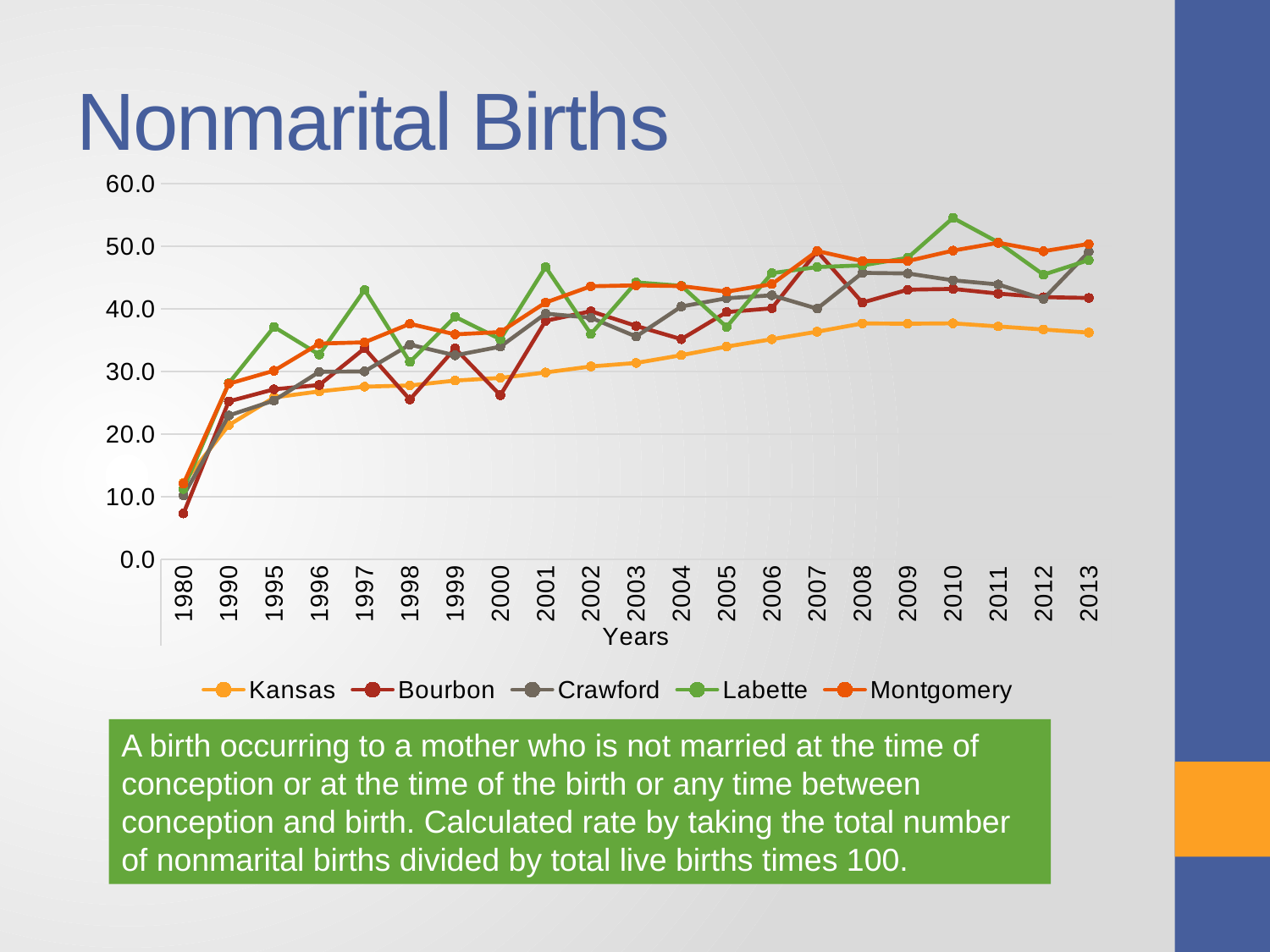
Is the value for Labette in 2010 greater or less than 50? greater How many years are plotted along the x axis? 21 Is the value for Bourbon in 2000 greater or less than 30? less What kind of chart is shown on the slide? line chart Which series has the lowest value in 1980? Bourbon Which series has the lowest value in 2013? Kansas Which series has the highest value in 2010? Labette Does the Kansas line generally rise or fall from 1980 to 2013? rise What is the title of the x axis? Years Is the value for Kansas in 2013 greater or less than 40? less How many series does the legend list? 5 In 1998, which is larger: the value for Montgomery or the value for Bourbon? Montgomery